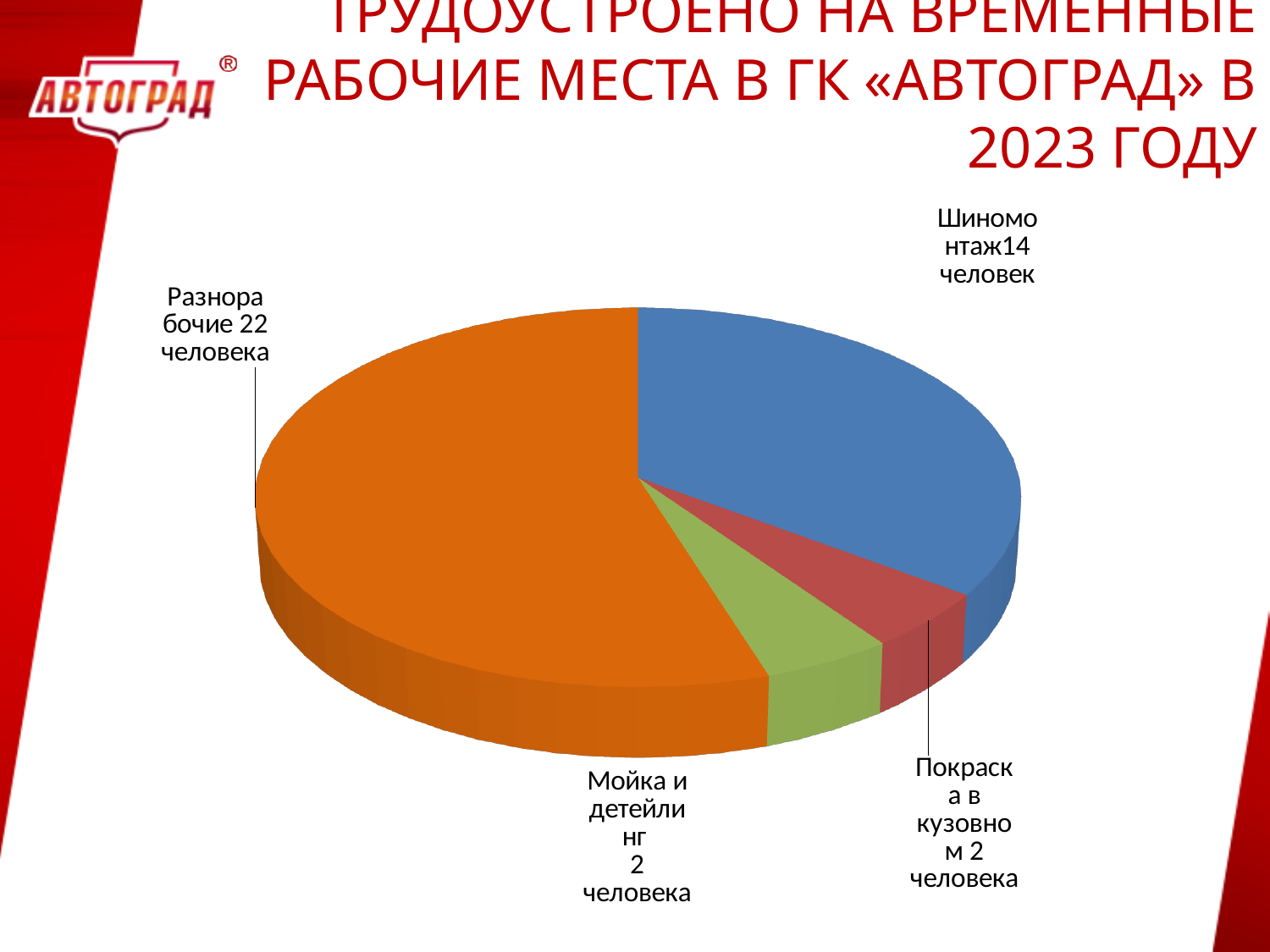
How many slices does the pie chart have? 4 How many people were employed in Покраска в кузовном according to the chart? 2 человека What share of the pie does the Разнорабочие slice represent? 55% What kind of chart is shown on the slide? Pie chart What is the difference between the number of people in Разнорабочие and in Шиномонтаж? 8 Which is larger: the number of people in Шиномонтаж or in Разнорабочие? Разнорабочие What is the total number of people shown across all slices of the pie chart? 40 Which category has the largest slice of the pie? Разнорабочие How many people were employed as Разнорабочие according to the chart? 22 человека What colour is the Шиномонтаж slice in the pie chart? Blue How many people were employed in Шиномонтаж according to the chart? 14 человек How many people were employed in Мойка и детейлинг according to the chart? 2 человека